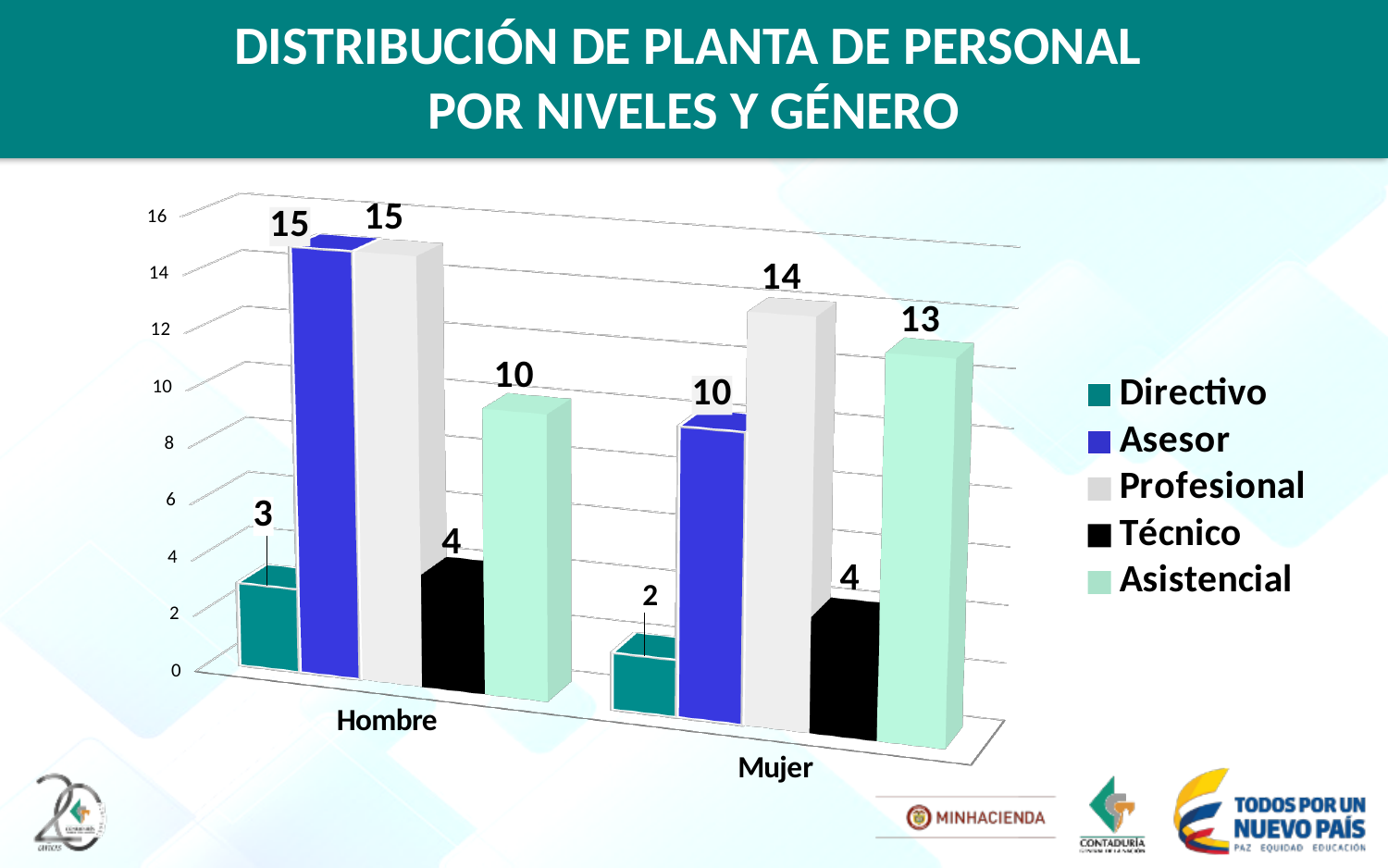
Which is larger, the Asistencial value for Hombre or for Mujer? Mujer How many series does the legend list? 5 What is the value for Profesional in the Mujer category? 14 What kind of chart is shown on the slide? Bar chart What is the value for Asistencial in the Mujer category? 13 What is the difference between the Asesor values for Hombre and Mujer? 5 What is the value for Asesor in the Hombre category? 15 What is the value for Directivo in the Hombre category? 3 Which series has the lowest value in the Mujer category? Directivo How many categories are shown on the x axis? 2 Which series has the highest value in the Mujer category? Profesional What is the total of all five series for the Hombre category? 47